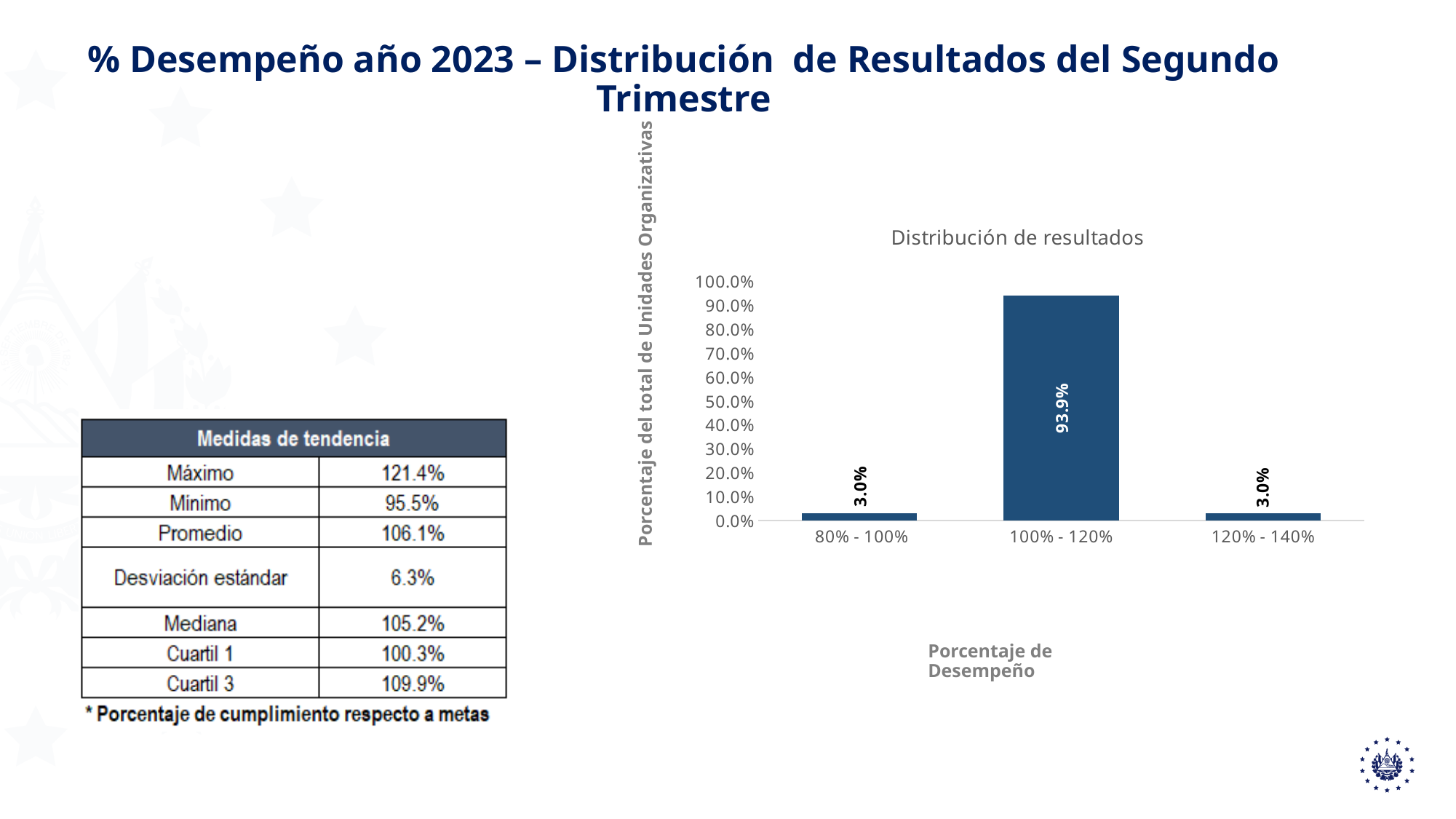
Is the value for 80% - 100% greater or less than 10.0%? less What is the value for the 100% - 120% category? 93.9% Which category has the highest value? 100% - 120% Which is larger, the value for 100% - 120% or the value for 120% - 140%? 100% - 120% Is the value for 100% - 120% greater or less than 90.0%? greater How many categories are shown on the x axis? 3 What is the value for the 120% - 140% category? 3.0% What kind of chart is shown? bar chart What is the difference between the values for 100% - 120% and 80% - 100%? 90.9% What is the value for the 80% - 100% category? 3.0% What is the label of the x axis? Porcentaje de Desempeño What is the title of the chart? Distribución de resultados